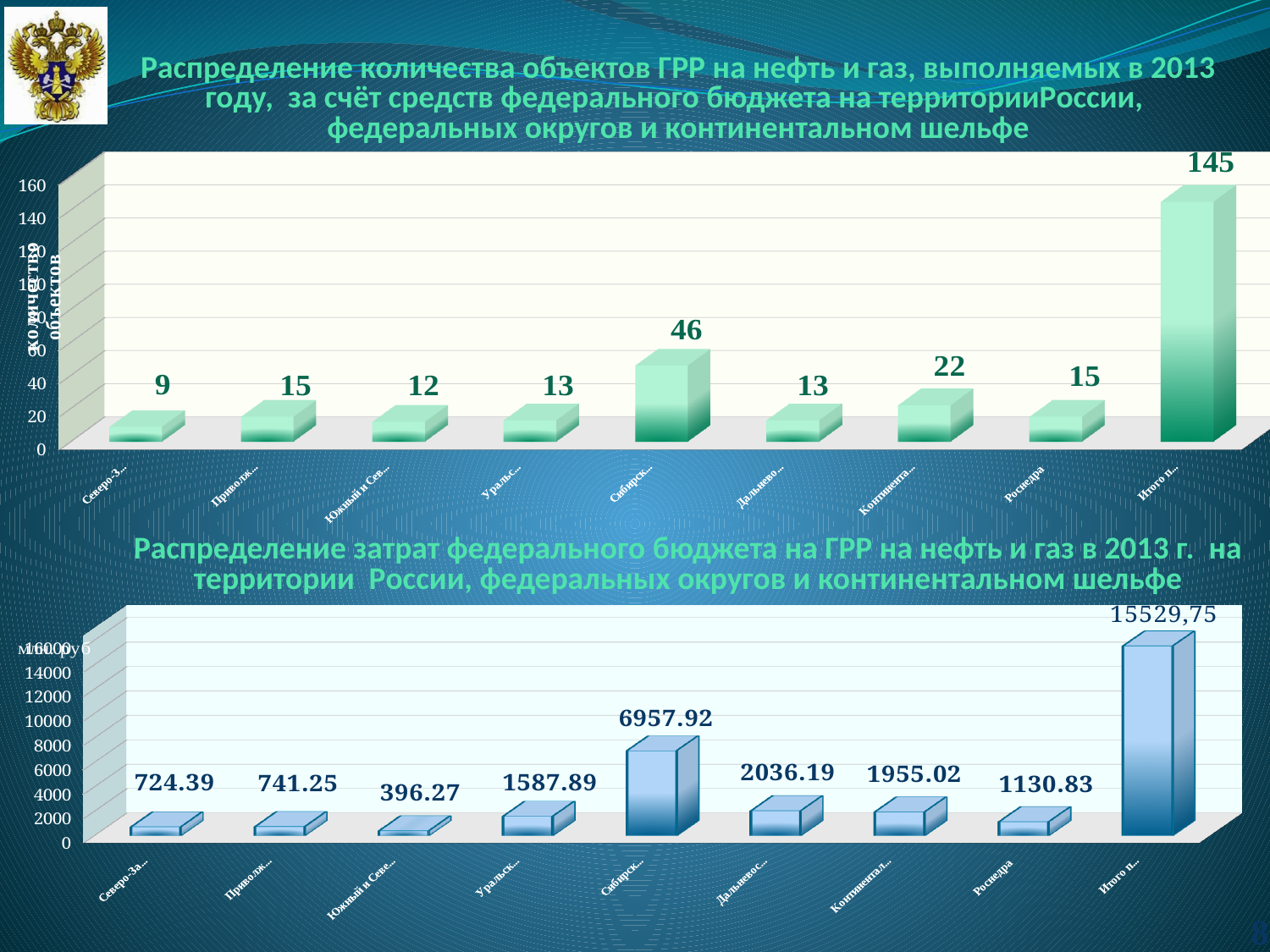
On the bottom chart, which is larger: the sixth bar (2036.19) or the seventh bar (1955.02)? 2036.19 On the bottom chart, what is the highest value shown? 15529,75 On the top chart, what is the highest value shown? 145 What type of chart is the bottom chart? Bar chart On the top chart, what is the value for Роснедра? 15 On the bottom chart, what is the value of the fifth bar from the left? 6957.92 On the bottom chart, what is the lowest value shown? 396.27 On the bottom chart, what is the value for Роснедра? 1130.83 How many bars are plotted on the top chart? 9 On the top chart, what is the value of the fifth bar from the left? 46 On the top chart, what is the lowest value shown? 9 On the top chart, what is the difference between the rightmost bar (145) and the fifth bar (46)? 99